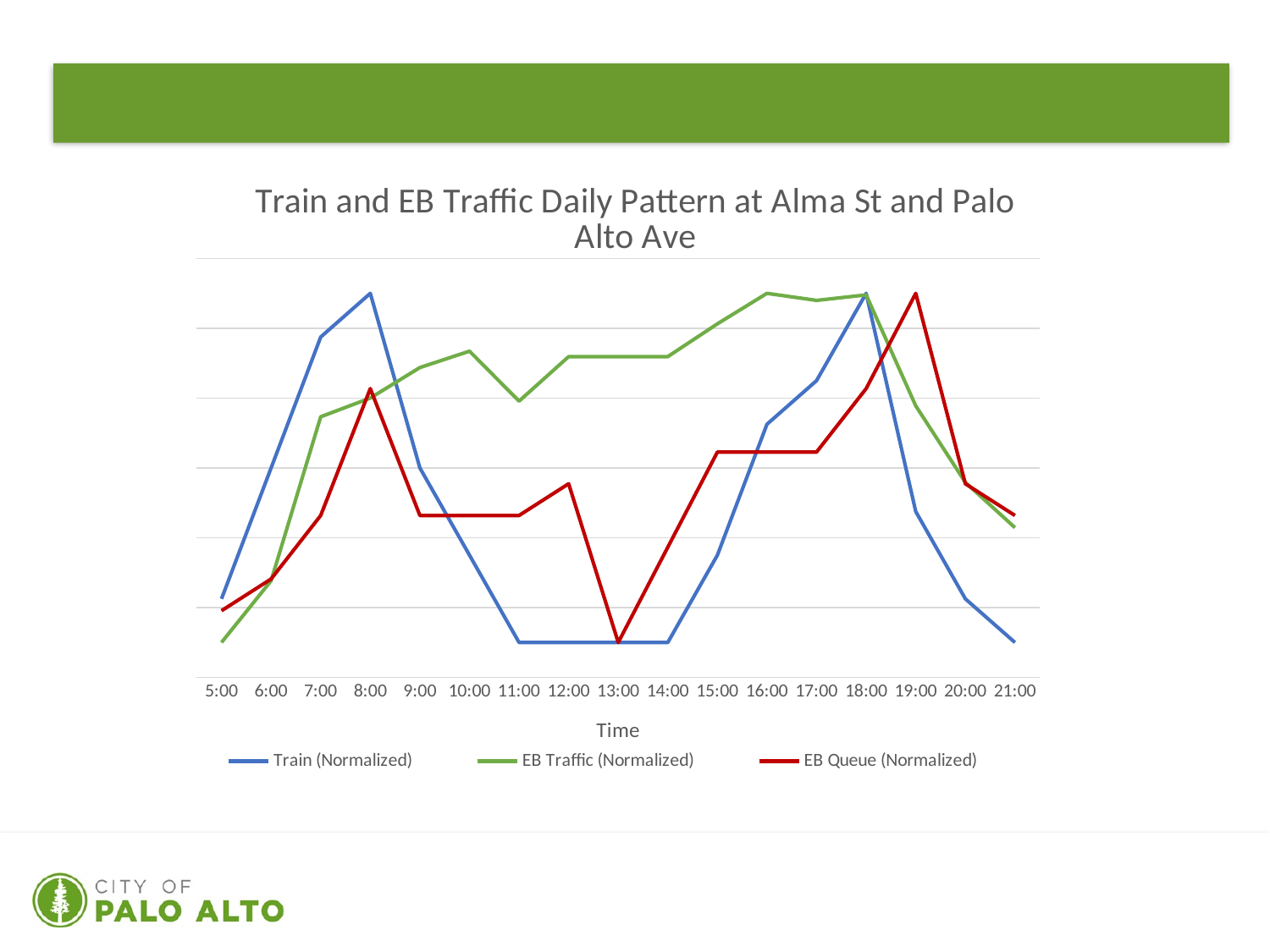
Does the EB Traffic (Normalized) series rise or fall from 5:00 to 8:00? rise At 8:00, which series is higher: Train (Normalized) or EB Queue (Normalized)? Train (Normalized) How many series does the legend list? 3 How many time points are shown along the x axis? 17 At 13:00, which series is higher: EB Traffic (Normalized) or Train (Normalized)? EB Traffic (Normalized) What is the title of the chart? Train and EB Traffic Daily Pattern at Alma St and Palo Alto Ave Does the Train (Normalized) series rise or fall from 18:00 to 21:00? fall At which time does the EB Traffic (Normalized) series reach its lowest value? 5:00 What is the label of the x axis? Time What kind of chart is shown on the slide? line chart At which time does the EB Queue (Normalized) series reach its lowest value? 13:00 At which time does the EB Queue (Normalized) series reach its highest value? 19:00